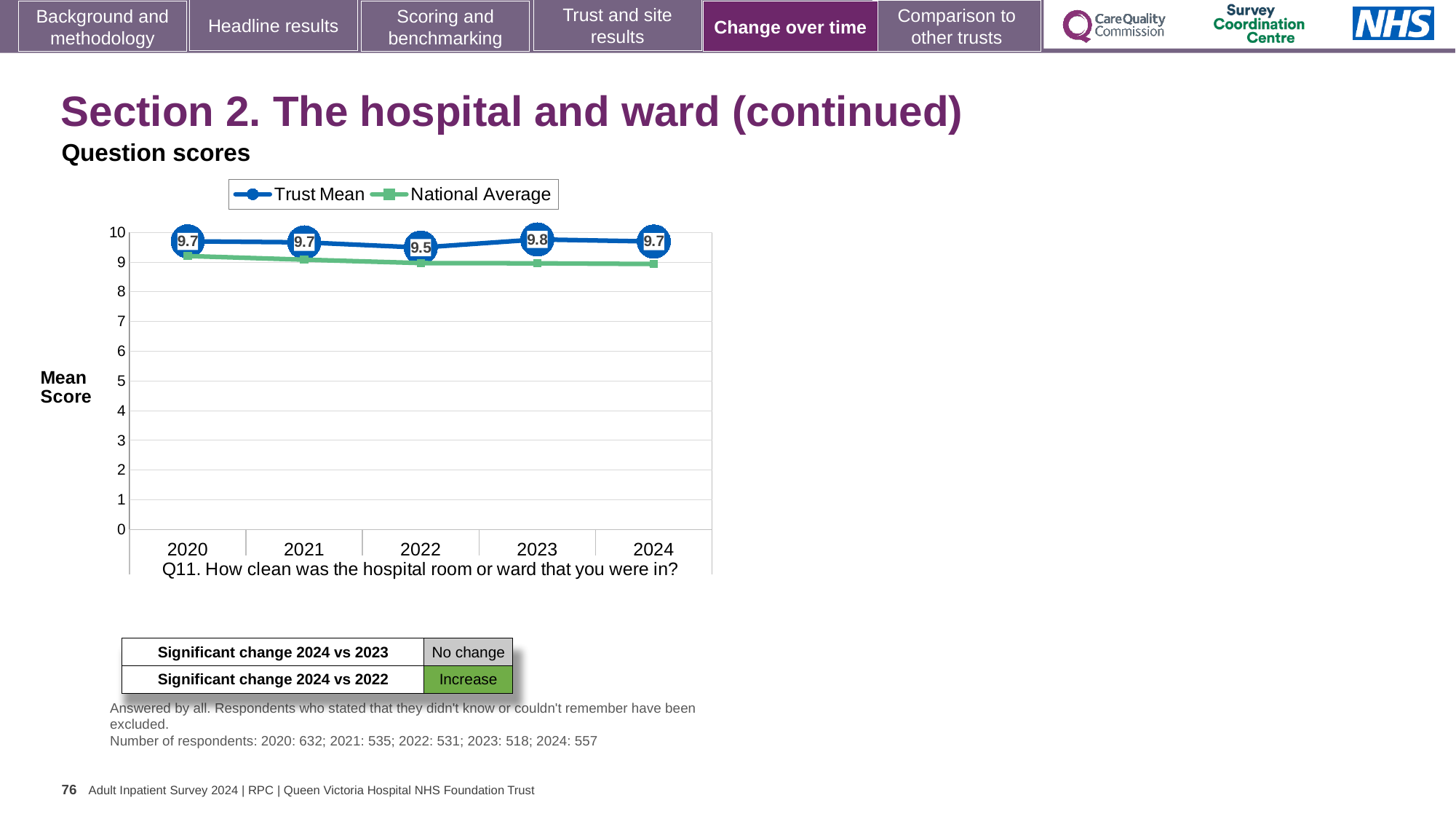
What is the Trust Mean score for 2023? 9.8 What is the Trust Mean score for 2020? 9.7 In which year is the Trust Mean lowest? 2022 In 2022, which is higher: the Trust Mean or the National Average? Trust Mean What kind of chart is shown on the slide? Line chart In which year is the Trust Mean highest? 2023 Does the Trust Mean rise or fall from 2022 to 2023? Rise How many series does the legend list? 2 Is the National Average value for 2020 greater or less than 8? greater How many years are plotted on the x axis? 5 What is the Trust Mean score for 2022? 9.5 What is the difference between the Trust Mean in 2023 and in 2022? 0.3